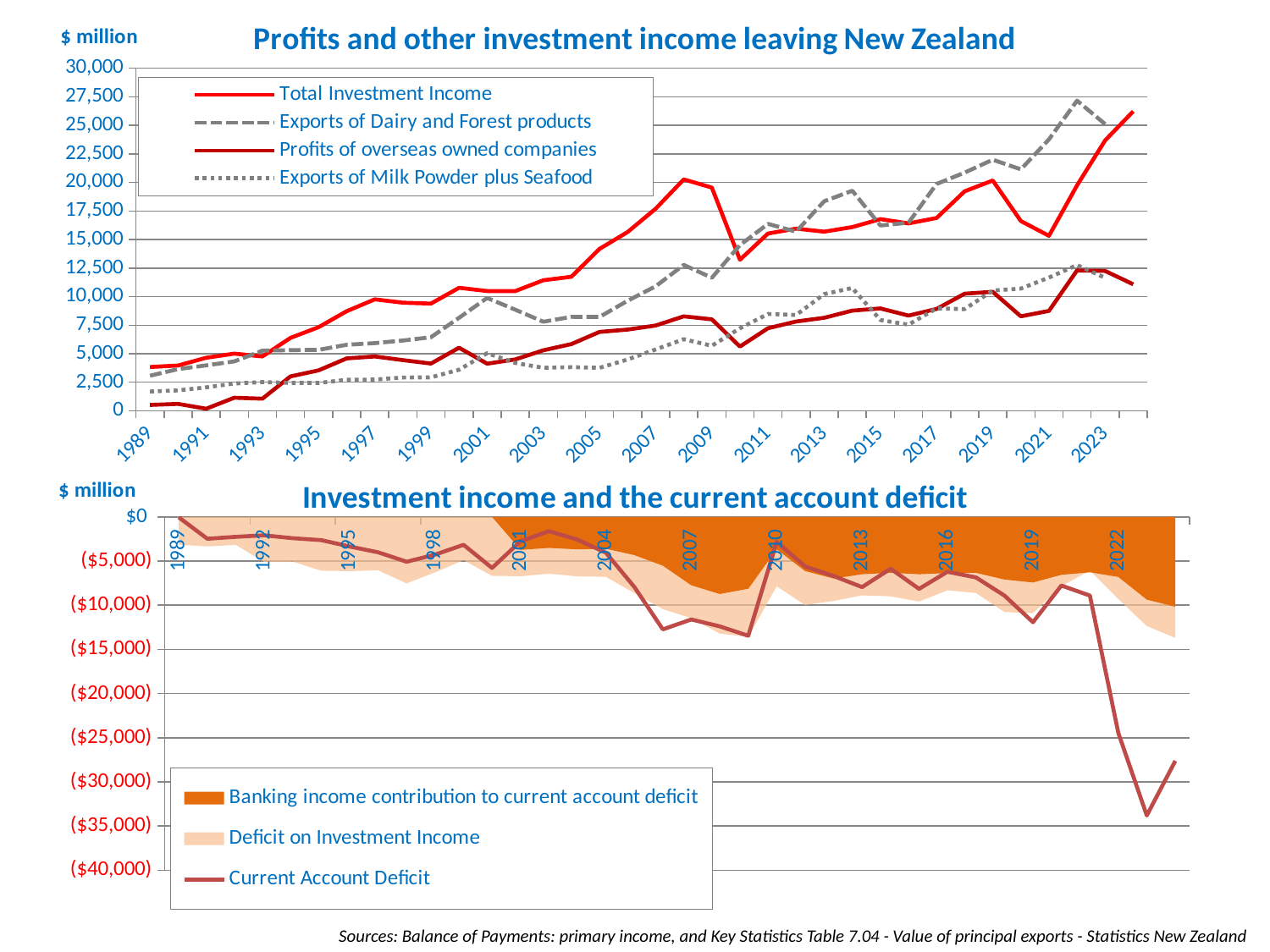
What type of chart is the top chart, 'Profits and other investment income leaving New Zealand'? line chart In the top chart, 'Profits and other investment income leaving New Zealand', which series has the highest value in 2022? Exports of Dairy and Forest products In the top chart, 'Profits and other investment income leaving New Zealand', which is larger in 2008: Total Investment Income or Exports of Dairy and Forest products? Total Investment Income In the bottom chart, 'Investment income and the current account deficit', in which year does the Current Account Deficit line reach its lowest point? 2023 What unit is shown on the y axis of the top chart, 'Profits and other investment income leaving New Zealand'? $ million In the bottom chart, 'Investment income and the current account deficit', is the Current Account Deficit in 2023 greater or less than ($30,000)? less In the top chart, 'Profits and other investment income leaving New Zealand', is the value for Profits of overseas owned companies in 1989 greater or less than 2,500? less In the top chart, 'Profits and other investment income leaving New Zealand', is the value for Total Investment Income in 2024 greater or less than 20,000? greater How many series does the legend of the top chart, 'Profits and other investment income leaving New Zealand', list? 4 How many series does the legend of the bottom chart, 'Investment income and the current account deficit', list? 3 In the top chart, 'Profits and other investment income leaving New Zealand', does Total Investment Income generally rise or fall from 1989 to 2024? rise